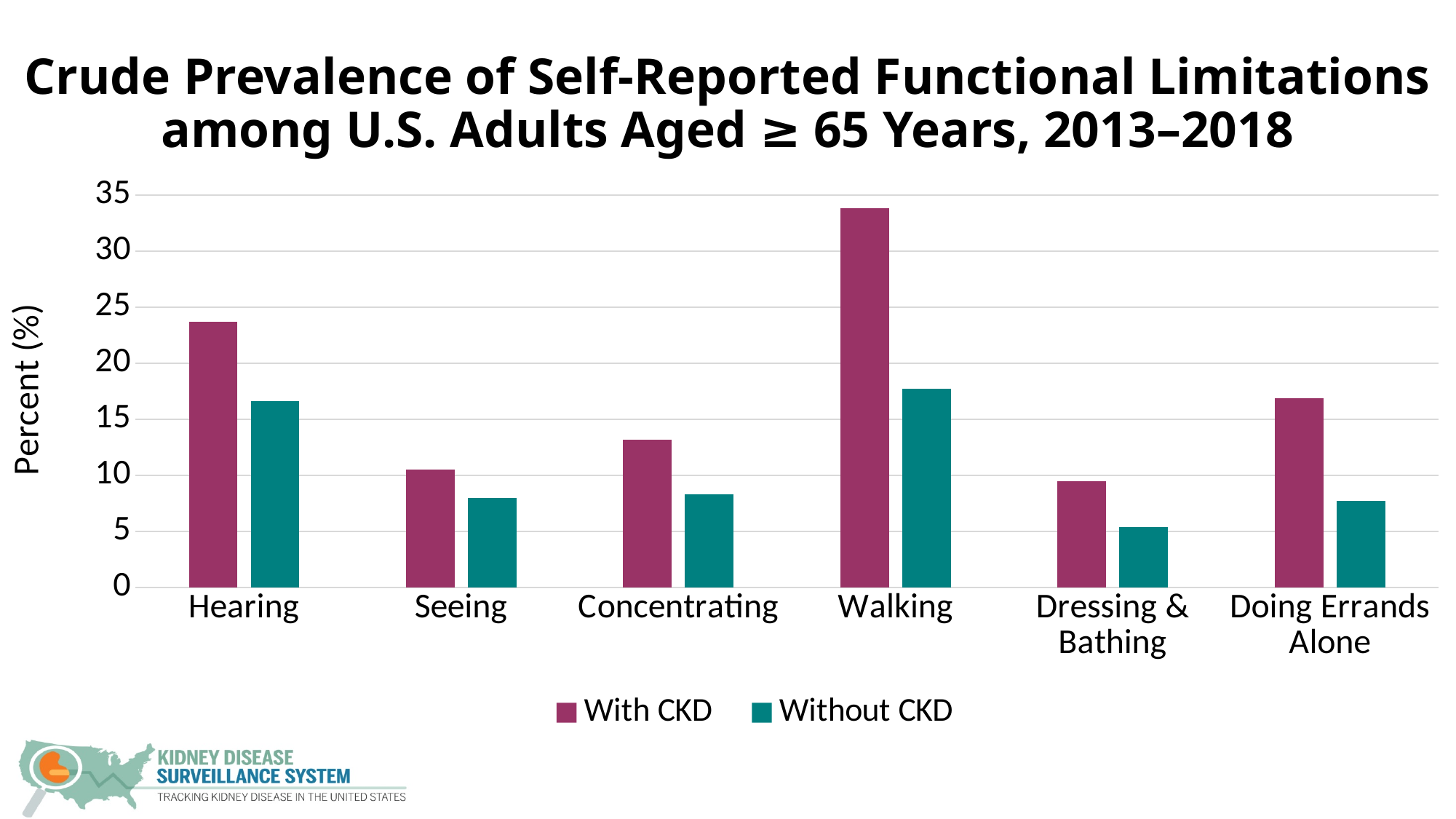
What is the label of the y axis? Percent (%) How many series does the legend list? 2 Which category has the lowest value for Without CKD? Dressing & Bathing What kind of chart is shown on the slide? bar chart How many functional limitation categories are shown on the x axis? 6 Which category has the highest value for With CKD? Walking Is the Without CKD value for Seeing greater or less than 10? less Which series is shown in teal? Without CKD Is the With CKD value for Walking greater or less than 30? greater Is the Without CKD value for Walking greater or less than 20? less For Doing Errands Alone, which is larger: the With CKD value or the Without CKD value? With CKD